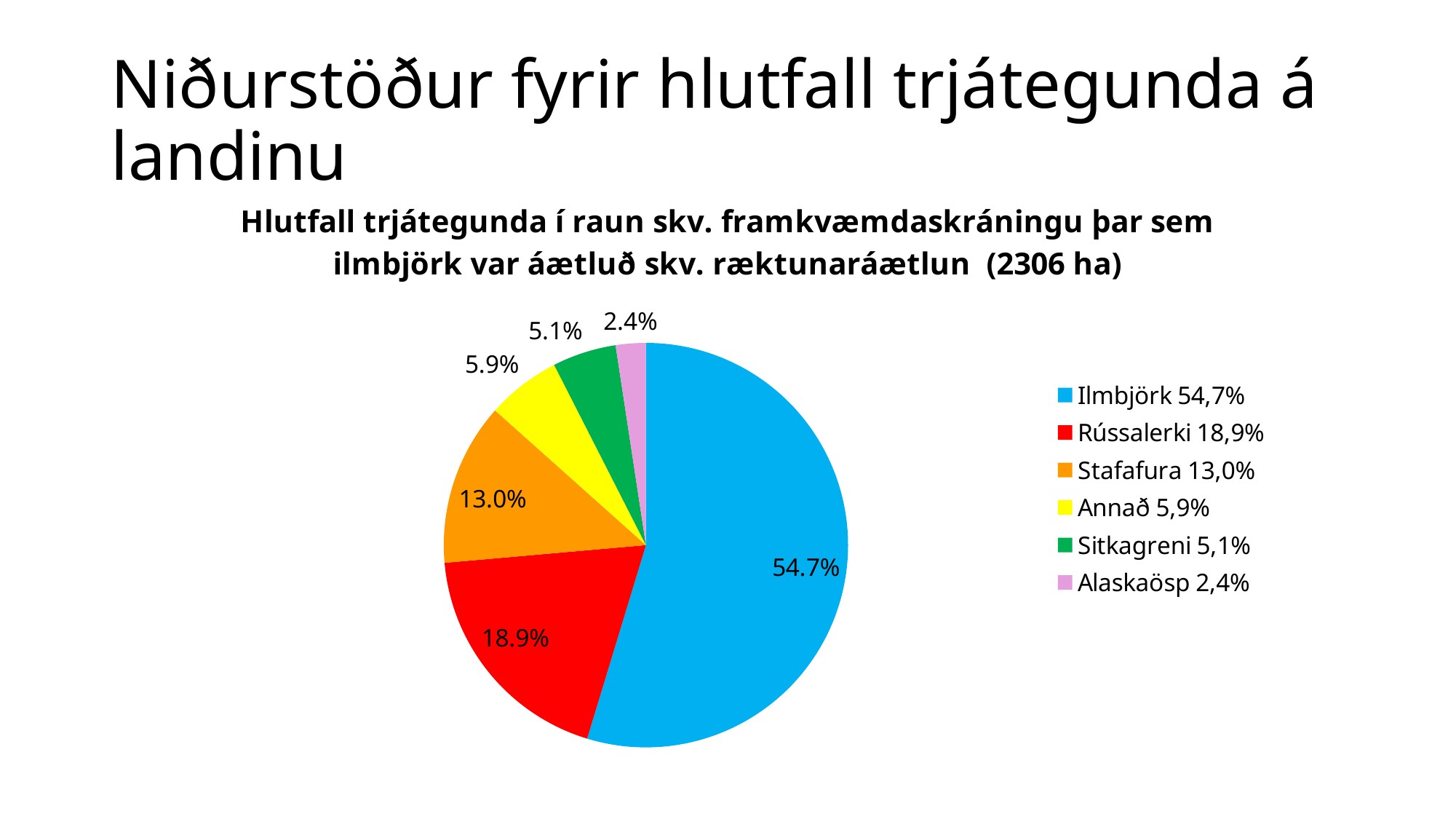
What share of the pie does Alaskaösp have? 2.4% What share of the pie does Stafafura have? 13.0% What colour is the Annað slice in the pie chart? yellow Which slice is larger, Rússalerki or Stafafura? Rússalerki Which category has the largest slice of the pie? Ilmbjörk What is the difference in percentage points between the Ilmbjörk and Rússalerki slices? 35.8 What share of the pie does Sitkagreni have? 5.1% What type of chart is shown on the slide? pie chart How many slices does the pie chart have? 6 Which category has the smallest slice of the pie? Alaskaösp